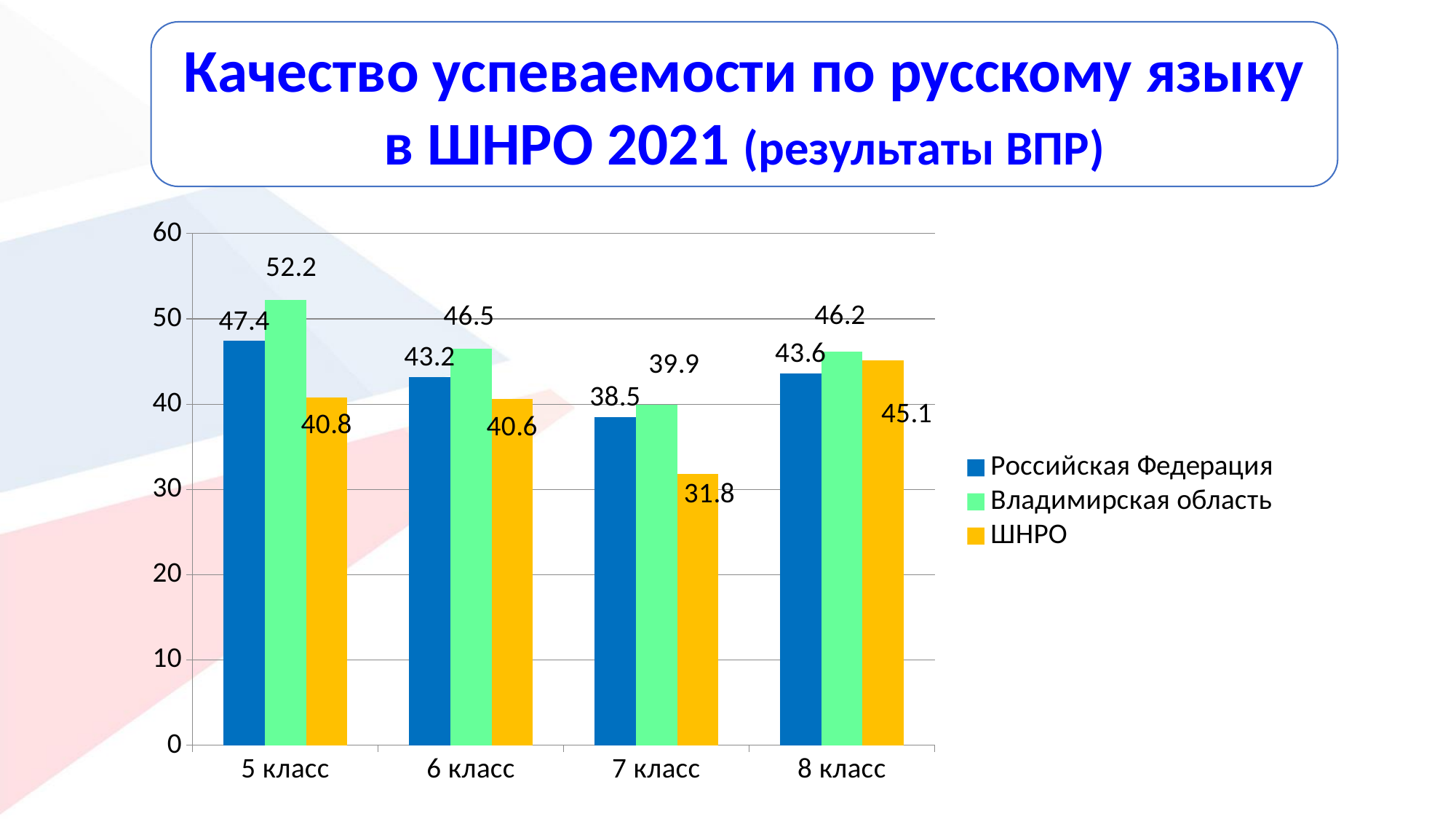
In which class is the Владимирская область value the highest? 5 класс What is the difference between Российская Федерация and ШНРО in 7 класс? 6.7 What is the value for Владимирская область in 8 класс? 46.2 What kind of chart is shown on the slide? Bar chart What is the difference between Владимирская область and ШНРО in 5 класс? 11.4 How many classes are shown on the x axis? 4 What is the value for Российская Федерация in 5 класс? 47.4 How many series does the legend list? 3 What is the value for ШНРО in 7 класс? 31.8 In which class is the ШНРО value the lowest? 7 класс What is the value for ШНРО in 8 класс? 45.1 Which is larger in 6 класс: Российская Федерация or ШНРО? Российская Федерация